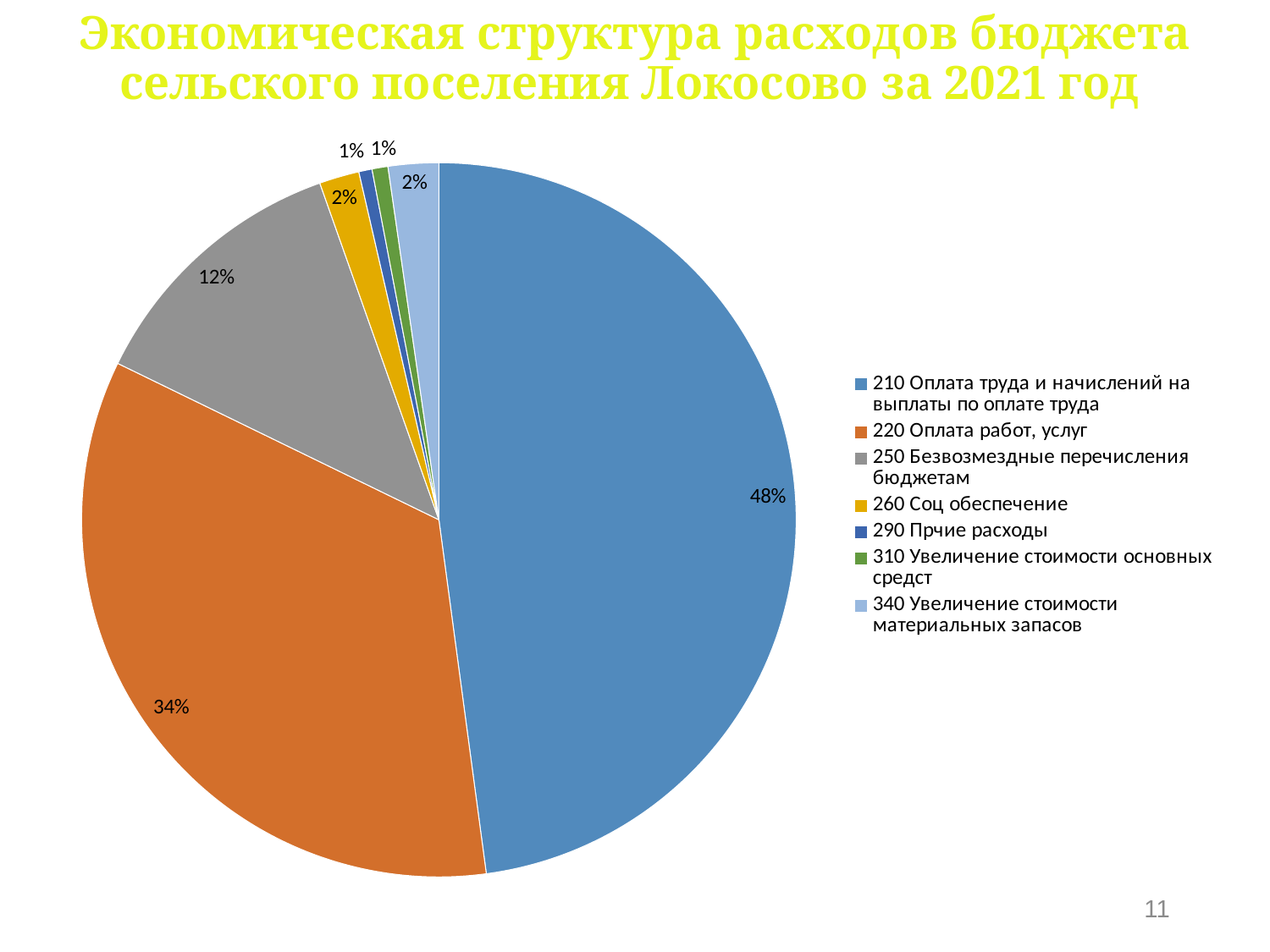
Which has a larger share: 250 Безвозмездные перечисления бюджетам or 340 Увеличение стоимости материальных запасов? 250 Безвозмездные перечисления бюджетам What is the title of the slide? Экономическая структура расходов бюджета сельского поселения Локосово за 2021 год What is the combined share of categories 210 and 220? 82% What percentage is shown for 260 Соц обеспечение? 2% By how many percentage points does the share of 210 Оплата труда exceed the share of 220 Оплата работ, услуг? 14 percentage points Which category has the largest share of the pie? 210 Оплата труда и начислений на выплаты по оплате труда What percentage is shown for 220 Оплата работ, услуг? 34% What share of budget expenditures does category 210 Оплата труда и начислений на выплаты по оплате труда account for? 48% How many categories are shown in the pie chart? 7 What percentage is shown for 250 Безвозмездные перечисления бюджетам? 12% What type of chart is shown on the slide? Pie chart What percentage is shown for 340 Увеличение стоимости материальных запасов? 2%